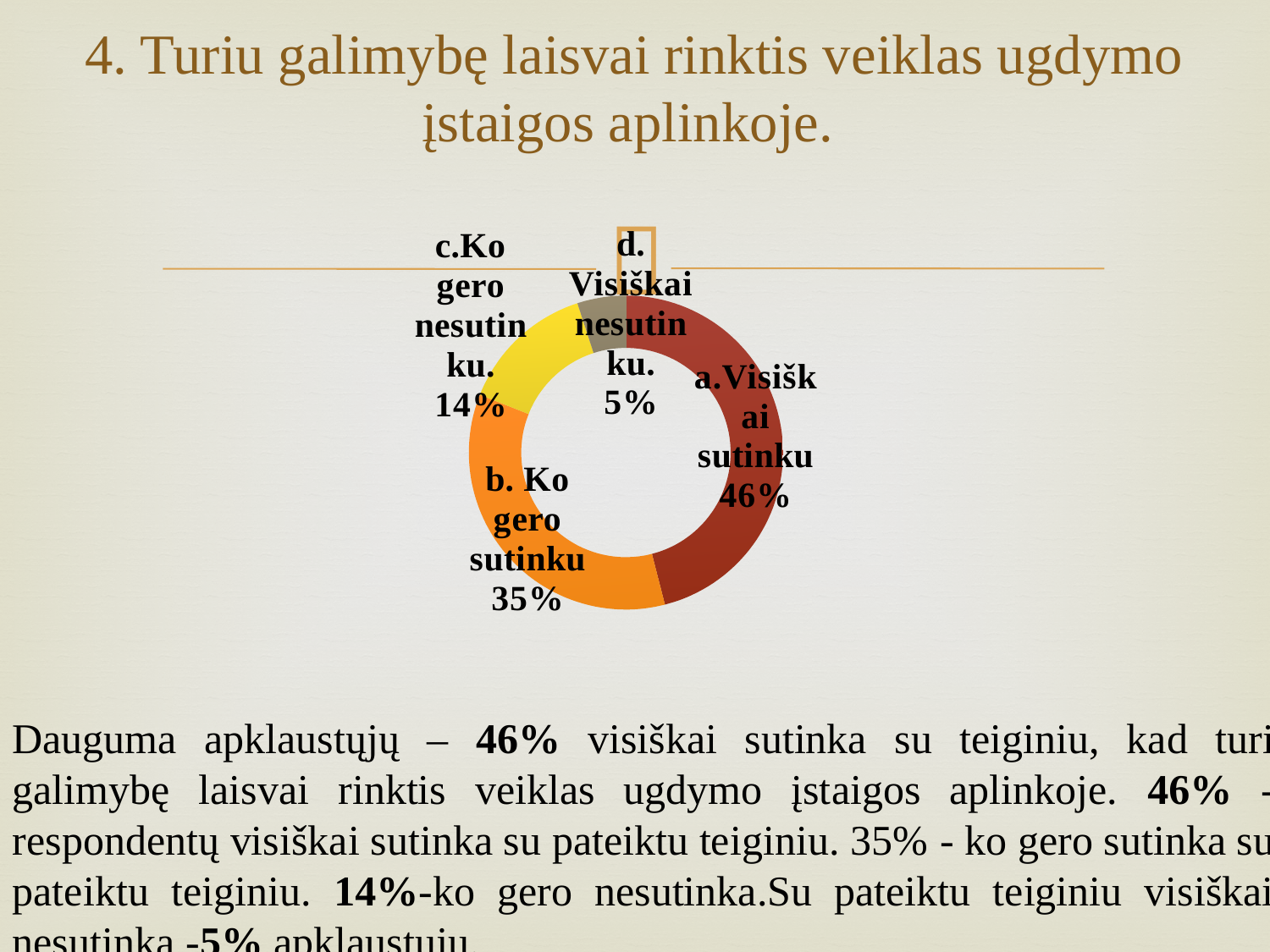
What colour is the segment for "c. Ko gero nesutinku"? Yellow Which category has the smallest share of the chart? d. Visiškai nesutinku What is the difference in percentage points between "c. Ko gero nesutinku" and "d. Visiškai nesutinku"? 9 What percentage is shown for "b. Ko gero sutinku"? 35% What percentage of respondents chose "a. Visiškai sutinku"? 46% What is the difference in percentage points between "a. Visiškai sutinku" and "b. Ko gero sutinku"? 11 What percentage is shown for "c. Ko gero nesutinku"? 14% How many categories are shown in the chart? 4 What percentage is shown for "d. Visiškai nesutinku"? 5% What kind of chart is shown on the slide? Doughnut (pie) chart Which is larger: the share for "b. Ko gero sutinku" or for "c. Ko gero nesutinku"? b. Ko gero sutinku Which category has the largest share of the chart? a. Visiškai sutinku